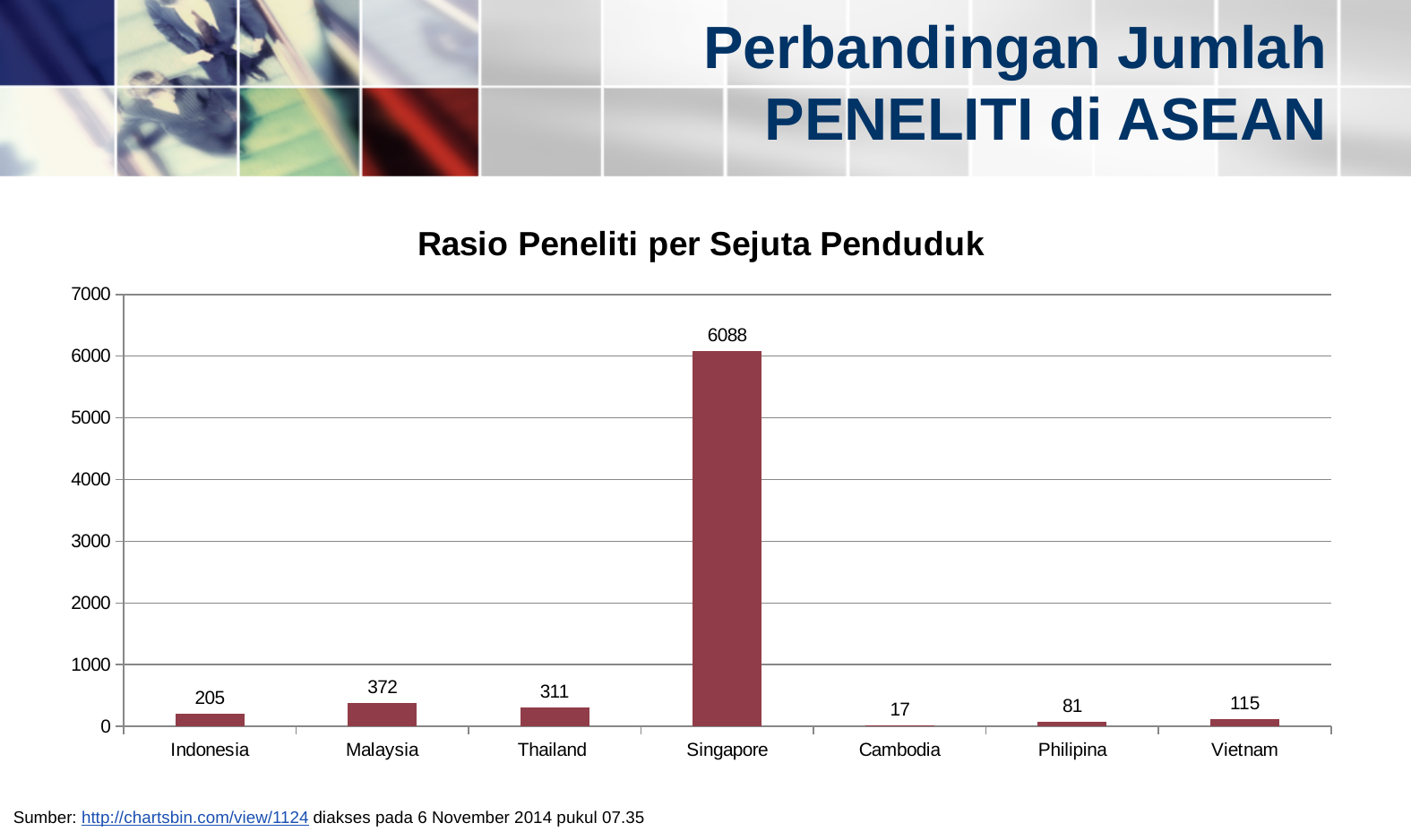
What is the value for Singapore? 6088 What is the difference between the values for Indonesia and Vietnam? 90 Which country has the highest ratio of researchers per million population? Singapore What kind of chart is this? Bar chart What is the value for Vietnam? 115 How many countries are shown on the chart? 7 What is the value for Cambodia? 17 What is the difference between the values for Malaysia and Thailand? 61 Which country has the lowest ratio of researchers per million population? Cambodia What is the title of the chart? Rasio Peneliti per Sejuta Penduduk What is the value for Malaysia? 372 Which is larger, the value for Indonesia or the value for Philipina? Indonesia